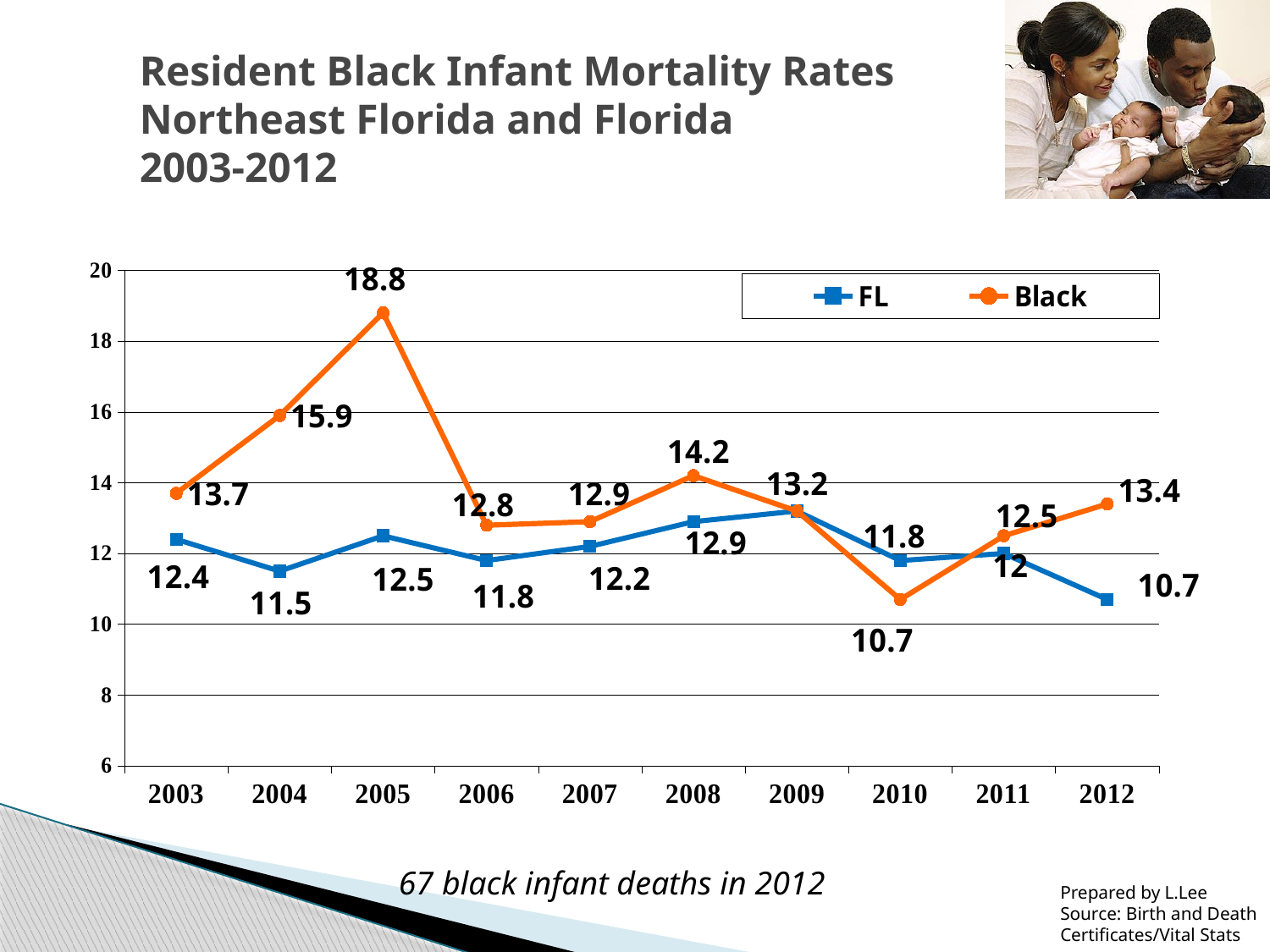
In which year is the Black series highest? 2005 What is the Black infant mortality rate for 2005? 18.8 What is the difference between the Black values for 2005 and 2004? 2.9 What is the Black value for 2010? 10.7 In 2010, which series has the larger value, FL or Black? FL In which year is the FL series lowest? 2012 What is the FL value for 2004? 11.5 In which year is the Black series lowest? 2010 How many series does the legend list? 2 What kind of chart is shown on the slide? Line chart How many years are plotted on the x axis? 10 In 2012, what is the difference between the Black value and the FL value? 2.7